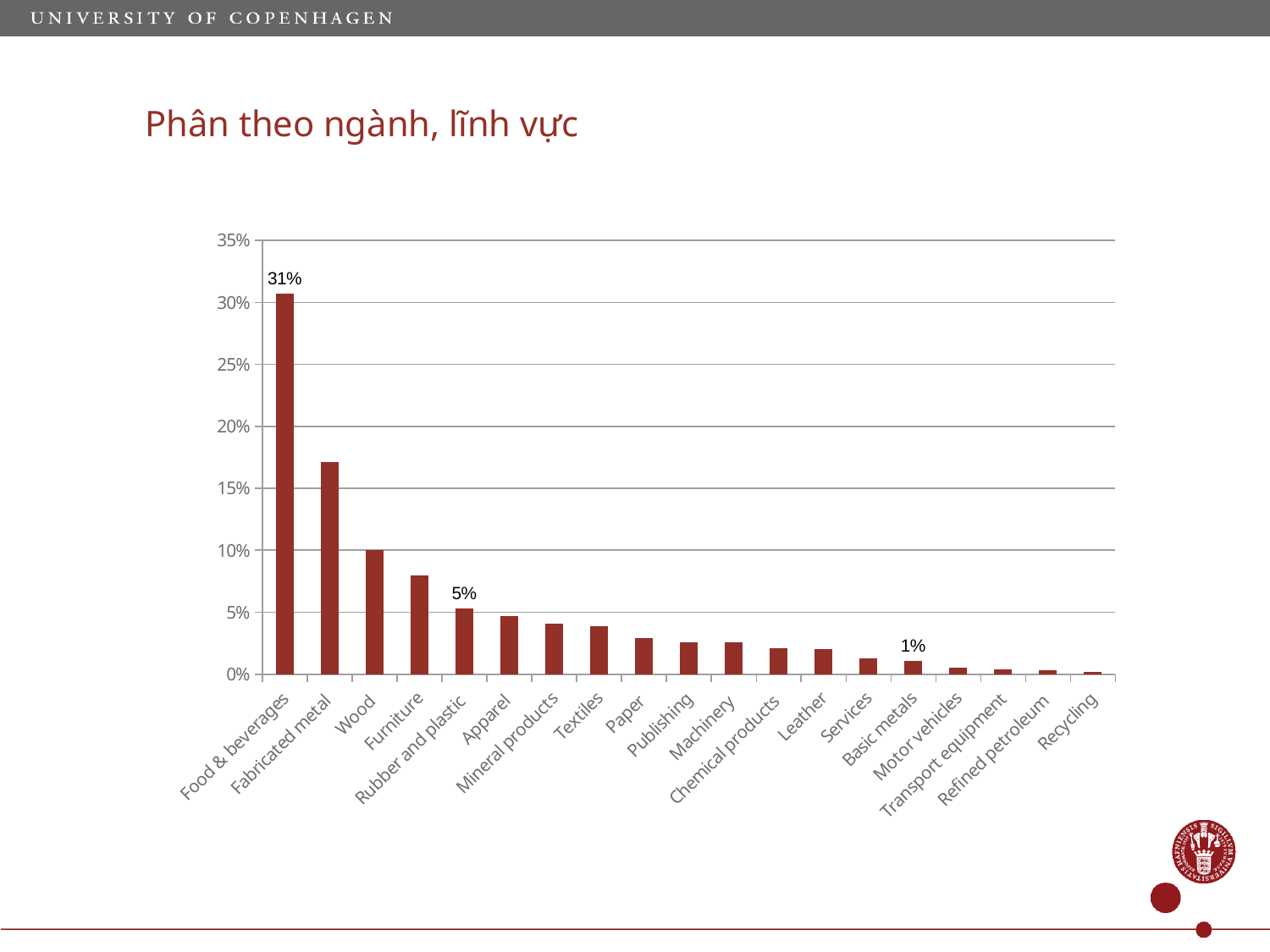
What is the value for Rubber and plastic? 5% How many categories are shown on the x axis? 19 What is the difference between the values for Food & beverages and Basic metals? 30% Which category has the lowest value? Recycling What is the value for Food & beverages? 31% Is the value for Furniture greater or less than 10%? less Which is larger, the value for Fabricated metal or the value for Wood? Fabricated metal What is the value for Basic metals? 1% Which category has the highest value? Food & beverages Is the value for Fabricated metal greater or less than 15%? greater What kind of chart is shown on the slide? bar chart What is the difference between the values for Food & beverages and Rubber and plastic? 26%